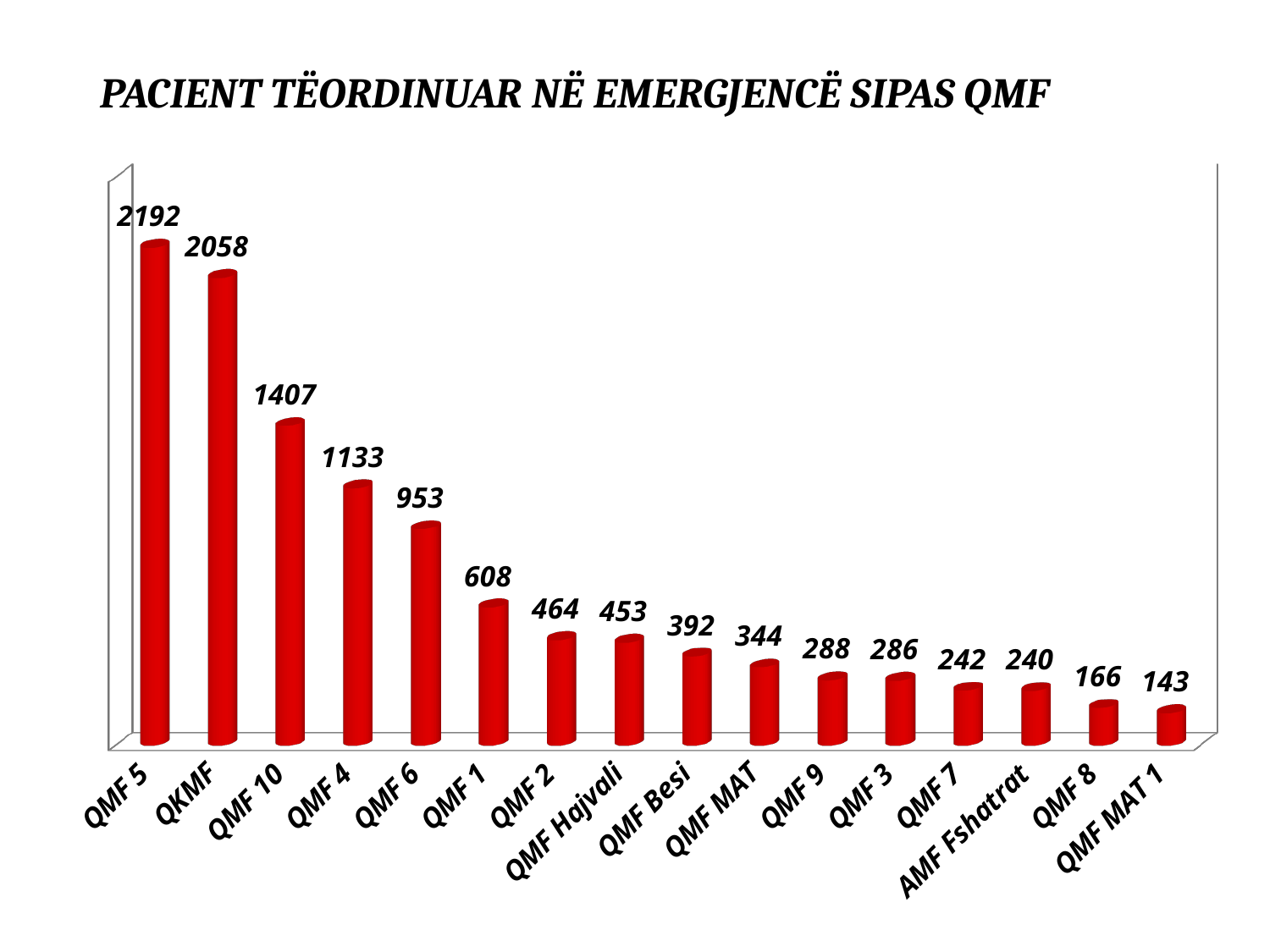
Which category has the highest value? QMF 5 What is the value for AMF Fshatrat? 240 What is the difference between the values for QMF 10 and QMF 4? 274 What is the value for QMF 5? 2192 Which category has the lowest value? QMF MAT 1 How many categories are shown on the x axis? 16 Do the values rise or fall from left to right along the x axis? fall Which is larger, the value for QMF 6 or the value for QMF 1? QMF 6 What is the value for QMF Hajvali? 453 What is the title of the chart? PACIENT TËORDINUAR NË EMERGJENCË SIPAS QMF What kind of chart is shown on the slide? bar chart What is the difference between the values for QMF 5 and QKMF? 134